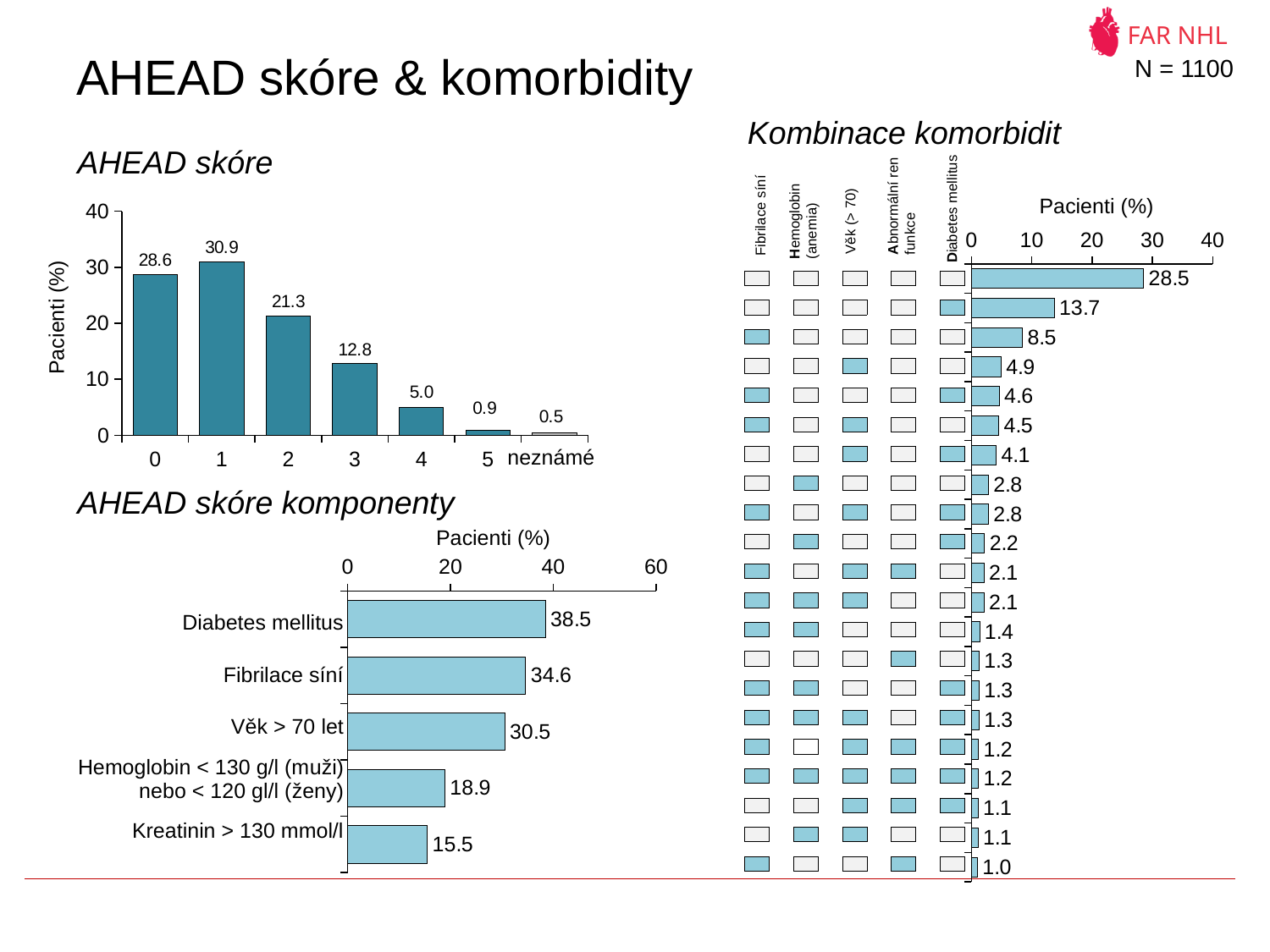
In the "AHEAD skóre" chart, do the values rise or fall from score 1 to score 5? fall In the "AHEAD skóre" chart, which score category has the highest percentage of patients? 1 In the "Kombinace komorbidit" chart, what is the value of the longest bar? 28.5 In the "AHEAD skóre" chart, how many categories are shown on the x axis? 7 In the "AHEAD skóre komponenty" chart, what is the value for Fibrilace síní? 34.6 In the "AHEAD skóre" chart, what percentage of patients have a score of 1? 30.9 In the "AHEAD skóre" chart, which category has the lowest value? neznámé In the "AHEAD skóre" chart, what is the difference between the values for score 0 and score 2? 7.3 In the "Kombinace komorbidit" chart, how many bars are plotted? 21 What kind of chart is the "AHEAD skóre komponenty" chart? bar chart In the "AHEAD skóre komponenty" chart, which is larger: Diabetes mellitus or Věk > 70 let? Diabetes mellitus In the "AHEAD skóre komponenty" chart, which component has the lowest percentage of patients? Kreatinin > 130 mmol/l